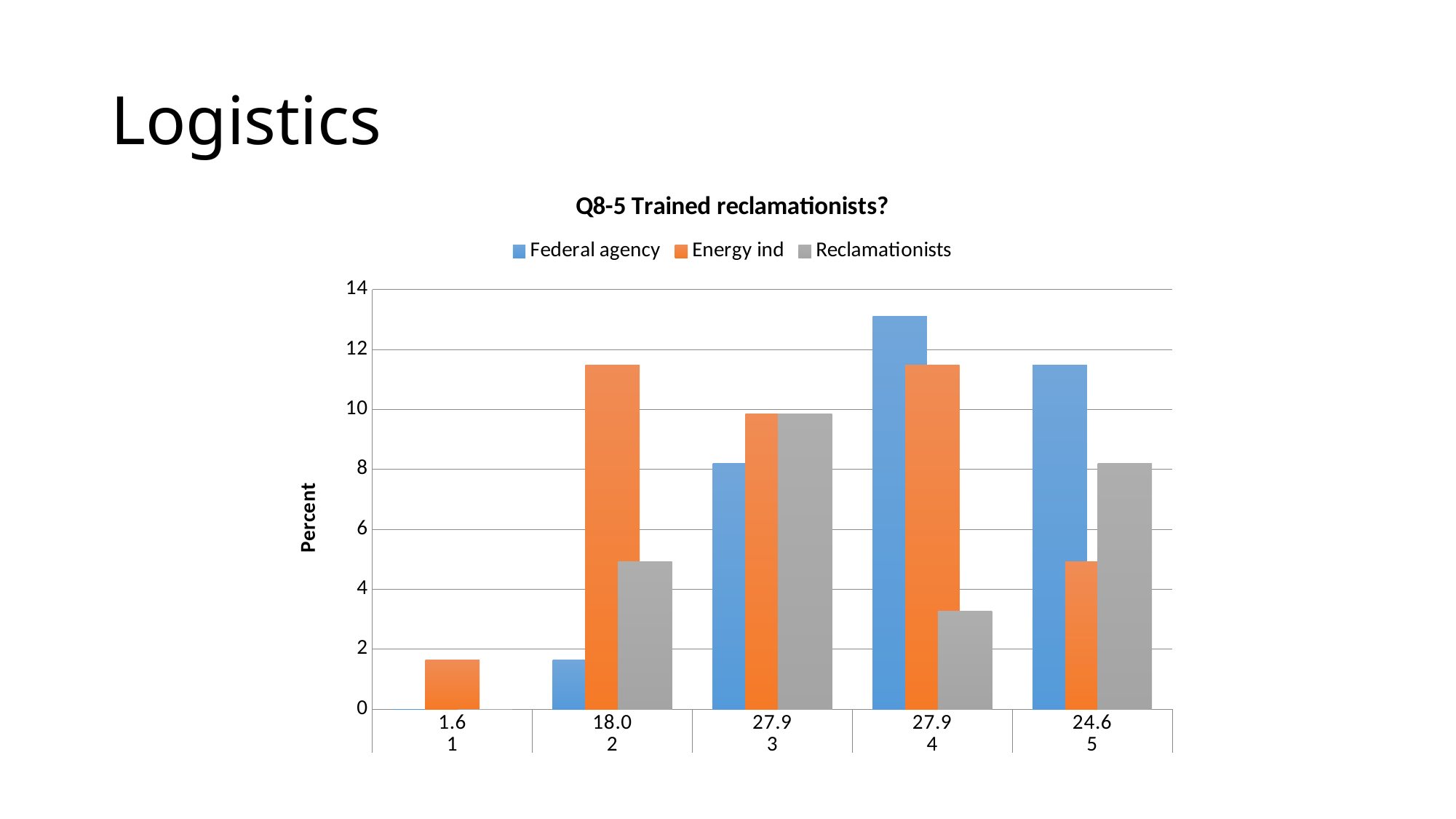
Is the Federal agency value for category 4 greater or less than 12? greater Is the Energy ind value for category 2 greater or less than 10? greater In category 2, which is larger: the Energy ind bar or the Reclamationists bar? Energy ind Is the Reclamationists value for category 4 greater or less than 4? less For which category is the Federal agency bar highest? 4 What is the label on the vertical axis? Percent What is the title of the chart? Q8-5 Trained reclamationists? In category 5, which is larger: the Federal agency bar or the Energy ind bar? Federal agency For which category is the Energy ind bar lowest? 1 How many series does the legend list? 3 What kind of chart is shown on the slide? bar chart How many categories are shown along the x axis? 5